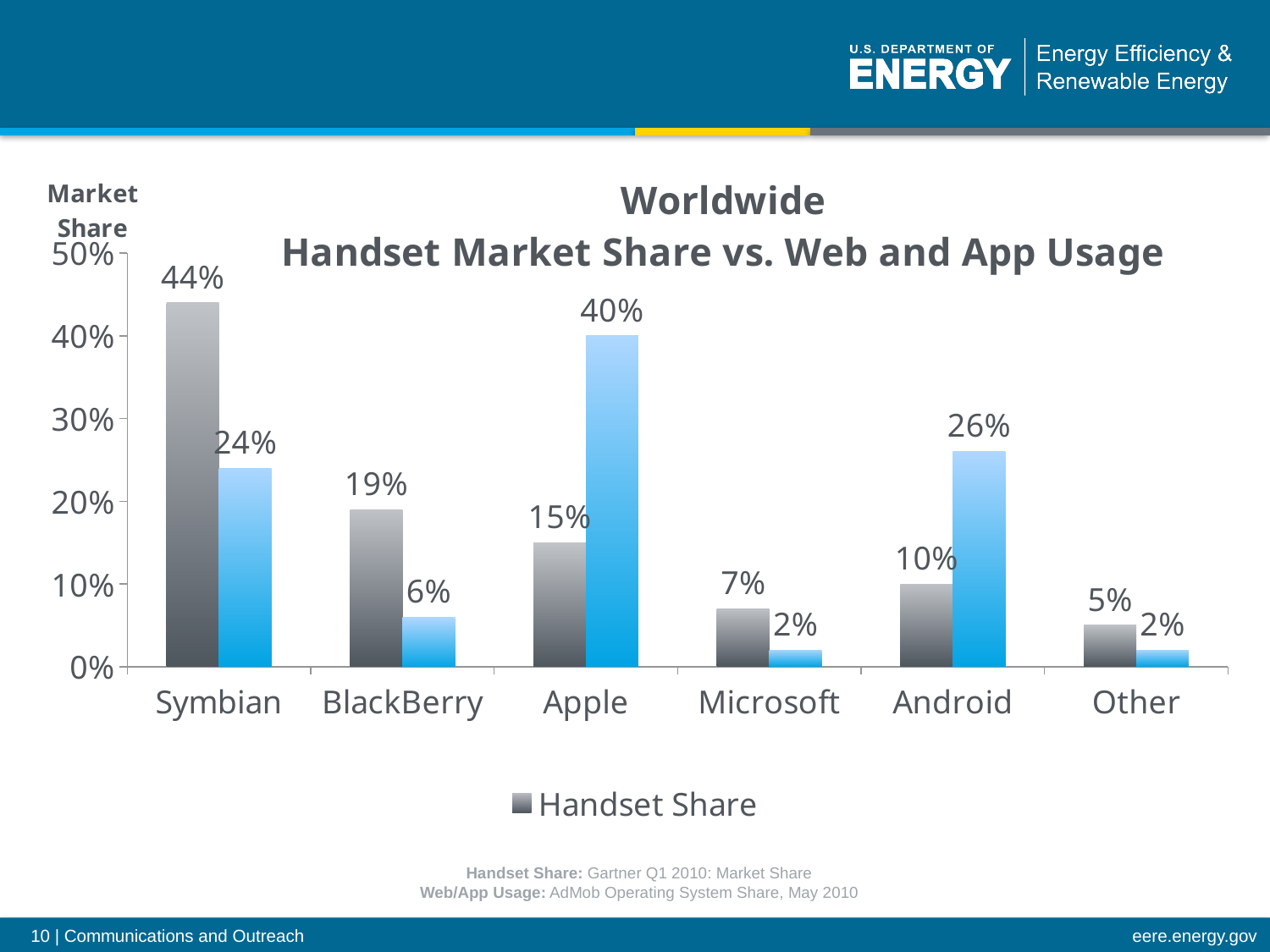
What is the difference between the Handset Share and the blue (Web/App Usage) bar for Symbian? 20% Which is larger for Android: the Handset Share bar or the blue (Web/App Usage) bar? Web/App Usage (26%) What is the value of the blue (Web/App Usage) bar for Apple? 40% How many categories are shown on the x axis? 6 What kind of chart is shown on the slide? Bar chart What is the Handset Share value for Symbian? 44% Which category has the highest blue (Web/App Usage) bar? Apple What is the title of the chart? Worldwide Handset Market Share vs. Web and App Usage Which category has the lowest Handset Share? Other What is the Handset Share value for Android? 10% What is the value of the blue (Web/App Usage) bar for BlackBerry? 6% Which category has the highest Handset Share? Symbian